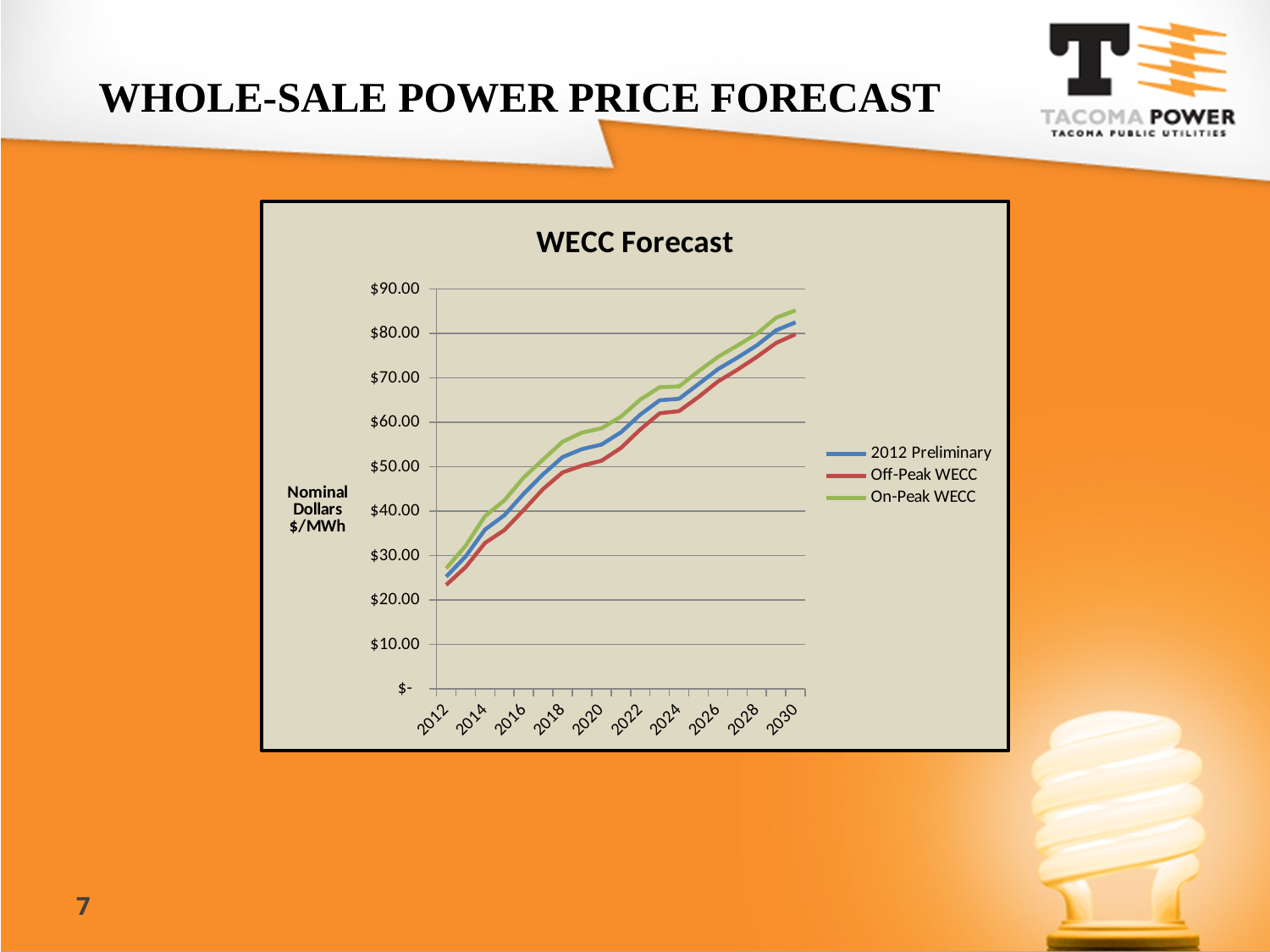
In the WECC Forecast chart, is the 2012 Preliminary value for 2030 greater or less than $70.00? greater What kind of chart is the WECC Forecast chart? line chart Which series in the WECC Forecast chart has the highest values across the forecast period? On-Peak WECC In the WECC Forecast chart, is the On-Peak WECC value for 2030 greater or less than $80.00? greater Do the values in the WECC Forecast chart rise or fall from 2012 to 2030? rise Which series in the WECC Forecast chart has the lowest values across the forecast period? Off-Peak WECC In the WECC Forecast chart, which is larger in 2030: On-Peak WECC or Off-Peak WECC? On-Peak WECC How many series does the legend of the WECC Forecast chart list? 3 In the WECC Forecast chart, is the Off-Peak WECC value for 2012 greater or less than $30.00? less What is the label on the vertical axis of the WECC Forecast chart? Nominal Dollars $/MWh What is the title of the chart on the slide? WECC Forecast How many year labels are shown on the x axis of the WECC Forecast chart? 10